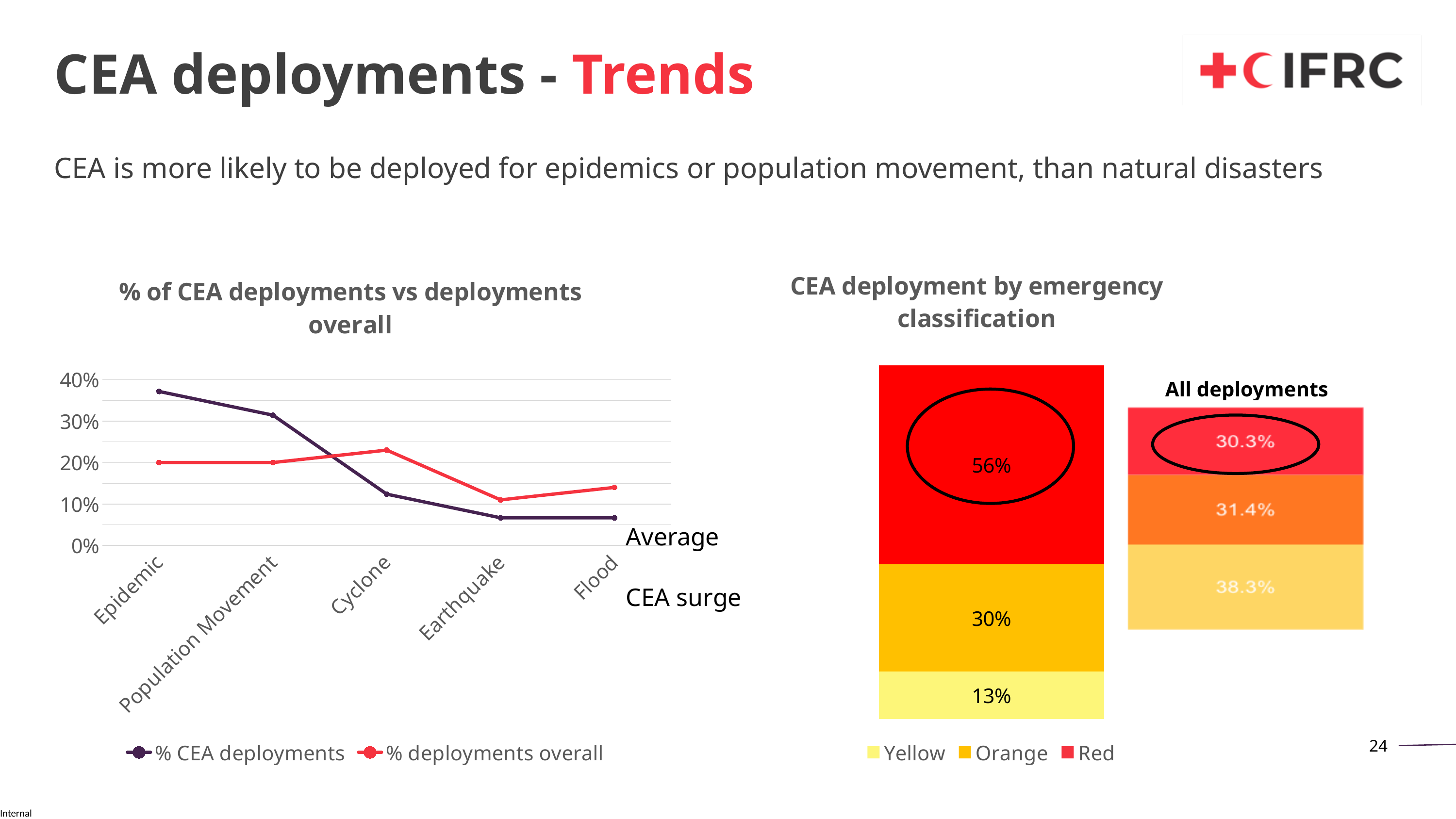
In the '% of CEA deployments vs deployments overall' chart, which series is higher at Cyclone: % CEA deployments or % deployments overall? % deployments overall In the 'CEA deployment by emergency classification' chart, what is the value for Yellow? 13% In the '% of CEA deployments vs deployments overall' chart, which emergency type has the highest % CEA deployments? Epidemic In the 'CEA deployment by emergency classification' chart, what is the difference between the Red and Orange values? 26% What kind of chart is the '% of CEA deployments vs deployments overall' chart? Line chart In the '% of CEA deployments vs deployments overall' chart, is the % CEA deployments value for Epidemic greater or less than 30%? greater How many series does the legend of the '% of CEA deployments vs deployments overall' chart list? 2 In the 'CEA deployment by emergency classification' chart, which classification has the largest share? Red In the '% of CEA deployments vs deployments overall' chart, does the % CEA deployments line rise or fall from Epidemic to Earthquake? Fall In the 'CEA deployment by emergency classification' chart, what is the value for Red? 56% How many emergency types are shown on the x axis of the '% of CEA deployments vs deployments overall' chart? 5 In the '% of CEA deployments vs deployments overall' chart, is the % CEA deployments value for Earthquake greater or less than 10%? less